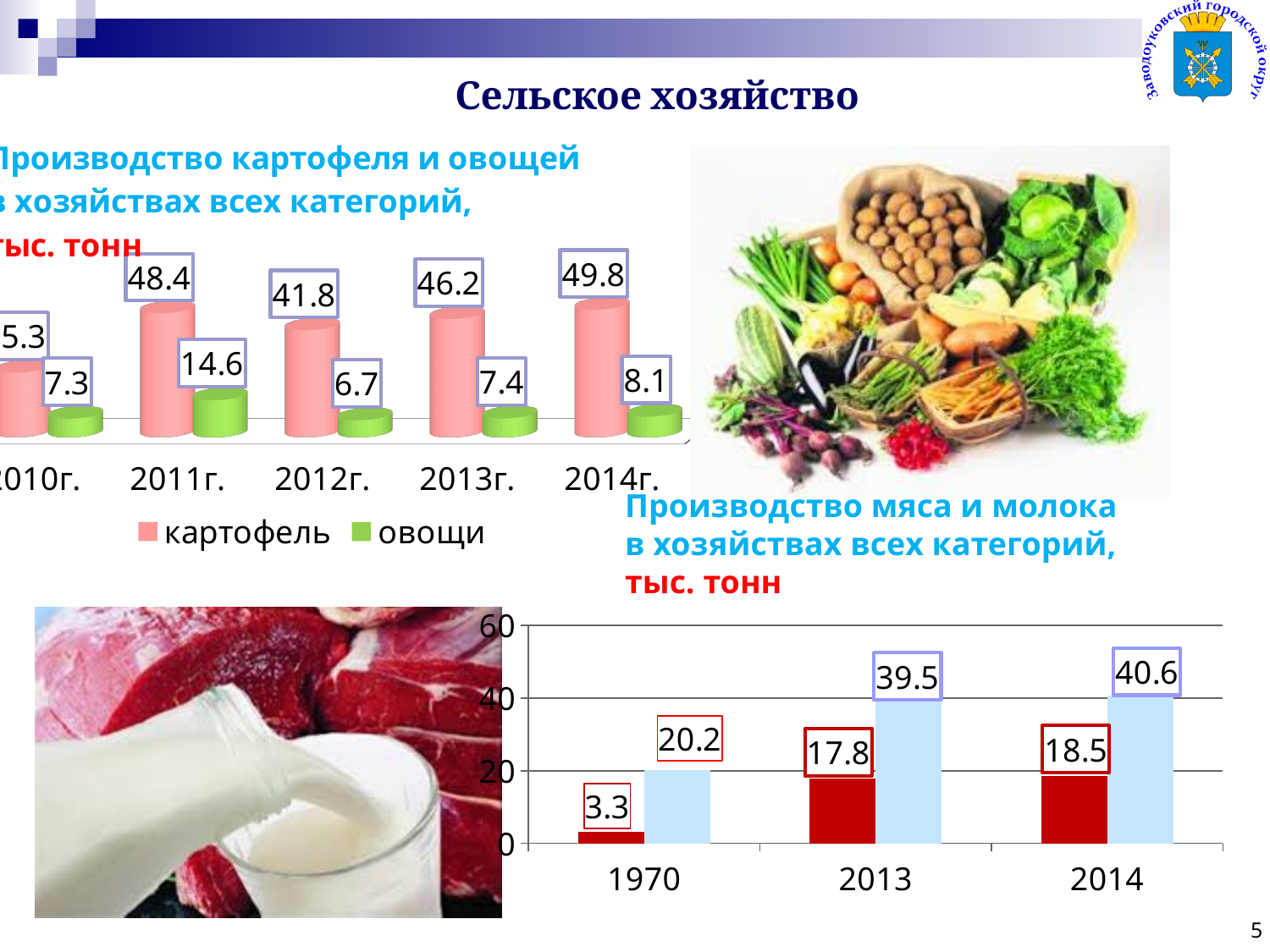
In the potato and vegetables chart (top left), how many series does the legend list? 2 In the potato and vegetables chart (top left), what is the difference between картофель and овощи in 2013г.? 38.8 In the meat and milk chart (bottom right), do the red bar values rise or fall from 1970 to 2014? rise In the potato and vegetables chart (top left), what is the value for картофель in 2014г.? 49.8 In the potato and vegetables chart (top left), which is larger: картофель in 2011г. or картофель in 2012г.? картофель in 2011г. In the potato and vegetables chart (top left), which year has the highest value for картофель? 2014г. In the potato and vegetables chart (top left), which year has the lowest value for овощи? 2012г. In the potato and vegetables chart (top left), what is the value for овощи in 2011г.? 14.6 In the meat and milk chart (bottom right), what is the value of the light blue bar for 1970? 20.2 In the meat and milk chart (bottom right), what is the value of the red bar for 2013? 17.8 In the meat and milk chart (bottom right), what is the difference between the light blue bar and the red bar in 2014? 22.1 In the meat and milk chart (bottom right), how many years are shown on the x axis? 3